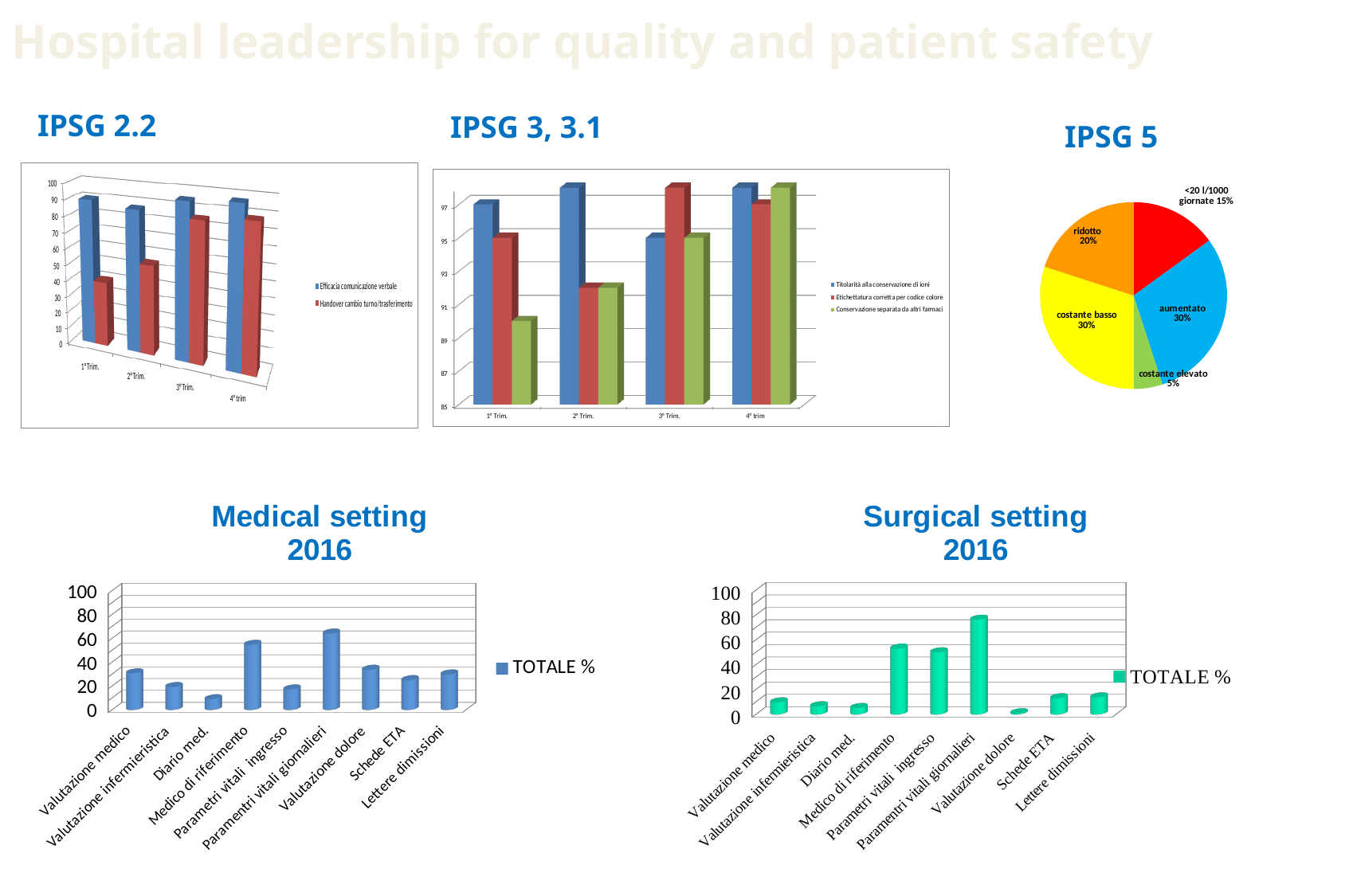
What kind of chart is the 'Medical setting 2016' chart? bar chart How many series does the legend of the IPSG 2.2 chart list? 2 How many series does the legend of the IPSG 3, 3.1 chart list? 3 In the 'Medical setting 2016' chart, which category has the highest value? Paramentri vitali giornalieri In the IPSG 2.2 chart, is the value for 'Handover cambio turno/trasferimento' in 1° Trim. greater or less than 50? less In the 'Surgical setting 2016' chart, which category has the lowest value? Valutazione dolore In the IPSG 2.2 chart, which series has the larger value in 1° Trim., 'Efficacia comunicazione verbale' or 'Handover cambio turno/trasferimento'? Efficacia comunicazione verbale In the 'Surgical setting 2016' chart, is the value for 'Paramentri vitali giornalieri' greater or less than 60? greater In the IPSG 5 pie chart, which slice is the smallest? costante elevato In the IPSG 5 pie chart, how many slices are there? 5 In the IPSG 5 pie chart, what share does the 'costante elevato' slice have? 5% In the IPSG 5 pie chart, what is the difference between the 'ridotto' share and the 'costante elevato' share? 15%